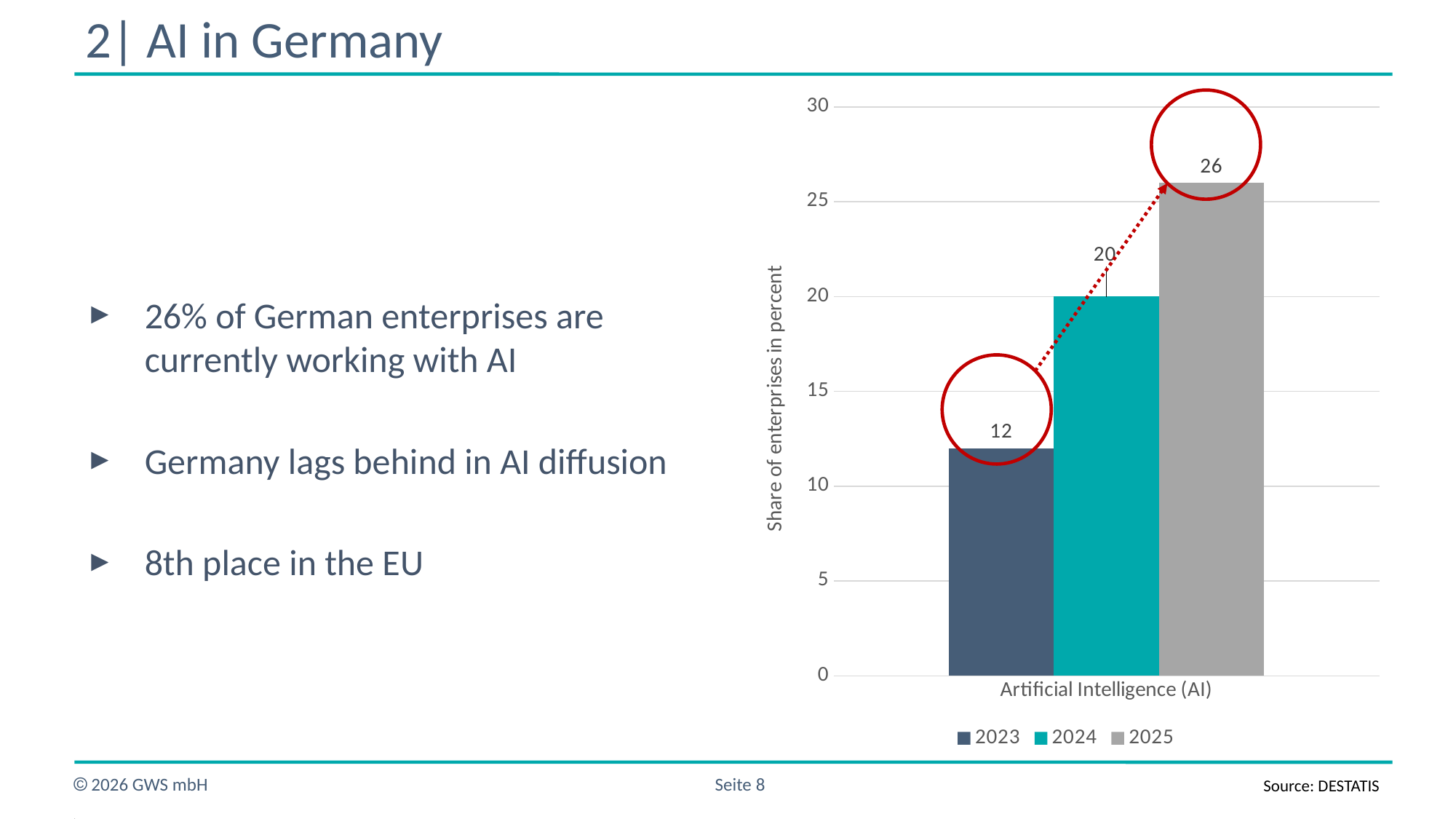
Is the value for 2025 greater or less than 25? greater What is the label of the y axis? Share of enterprises in percent What is the share of enterprises for 2023? 12 What is the share of enterprises for 2025? 26 Which year has the lowest share of enterprises? 2023 What kind of chart is shown on the slide? bar chart How many series does the legend list? 3 What is the difference between the 2025 and 2023 values? 14 What is the share of enterprises for 2024? 20 What is the difference between the 2024 and 2023 values? 8 Which is larger, the value for 2024 or the value for 2025? 2025 Which year has the highest share of enterprises? 2025